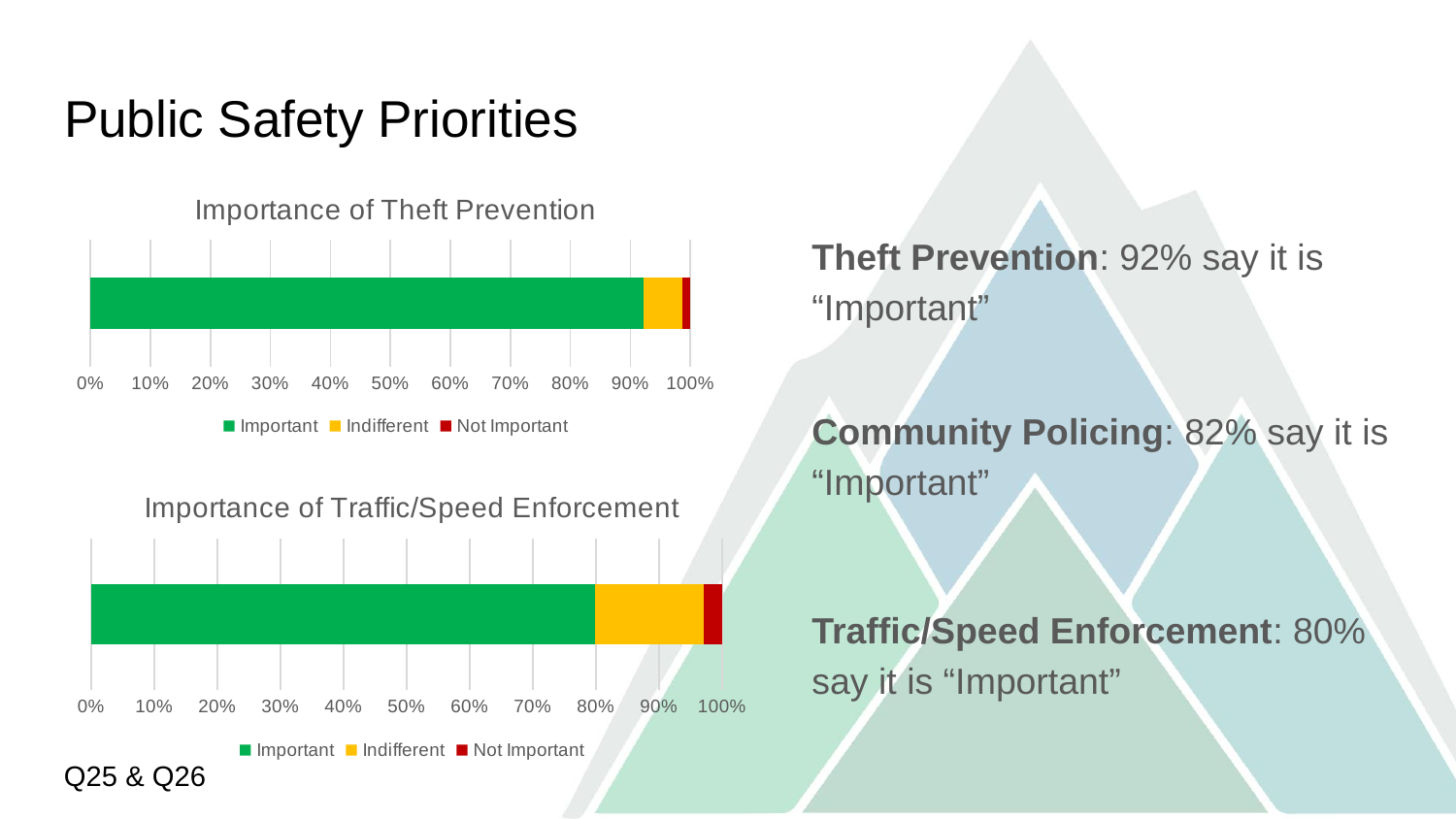
What is the difference between the "Important" percentages in the "Importance of Theft Prevention" and "Importance of Traffic/Speed Enforcement" charts? 12% What are the legend entries in the "Importance of Traffic/Speed Enforcement" chart? Important, Indifferent, Not Important Which chart shows a larger "Important" share: "Importance of Theft Prevention" or "Importance of Traffic/Speed Enforcement"? Importance of Theft Prevention In the "Importance of Theft Prevention" chart, is the "Important" value greater or less than 90%? greater In the "Importance of Theft Prevention" chart, what percentage say theft prevention is "Important"? 92% What kind of chart is the "Importance of Theft Prevention" chart? Stacked bar chart How many series does the legend of the "Importance of Theft Prevention" chart list? 3 In the "Importance of Theft Prevention" chart, which series has the smallest segment? Not Important What colour represents "Important" in the "Importance of Theft Prevention" chart? Green In the "Importance of Traffic/Speed Enforcement" chart, what percentage say traffic/speed enforcement is "Important"? 80% In the "Importance of Traffic/Speed Enforcement" chart, is the "Important" value greater or less than 90%? less In the "Importance of Traffic/Speed Enforcement" chart, which segment is larger: "Indifferent" or "Not Important"? Indifferent